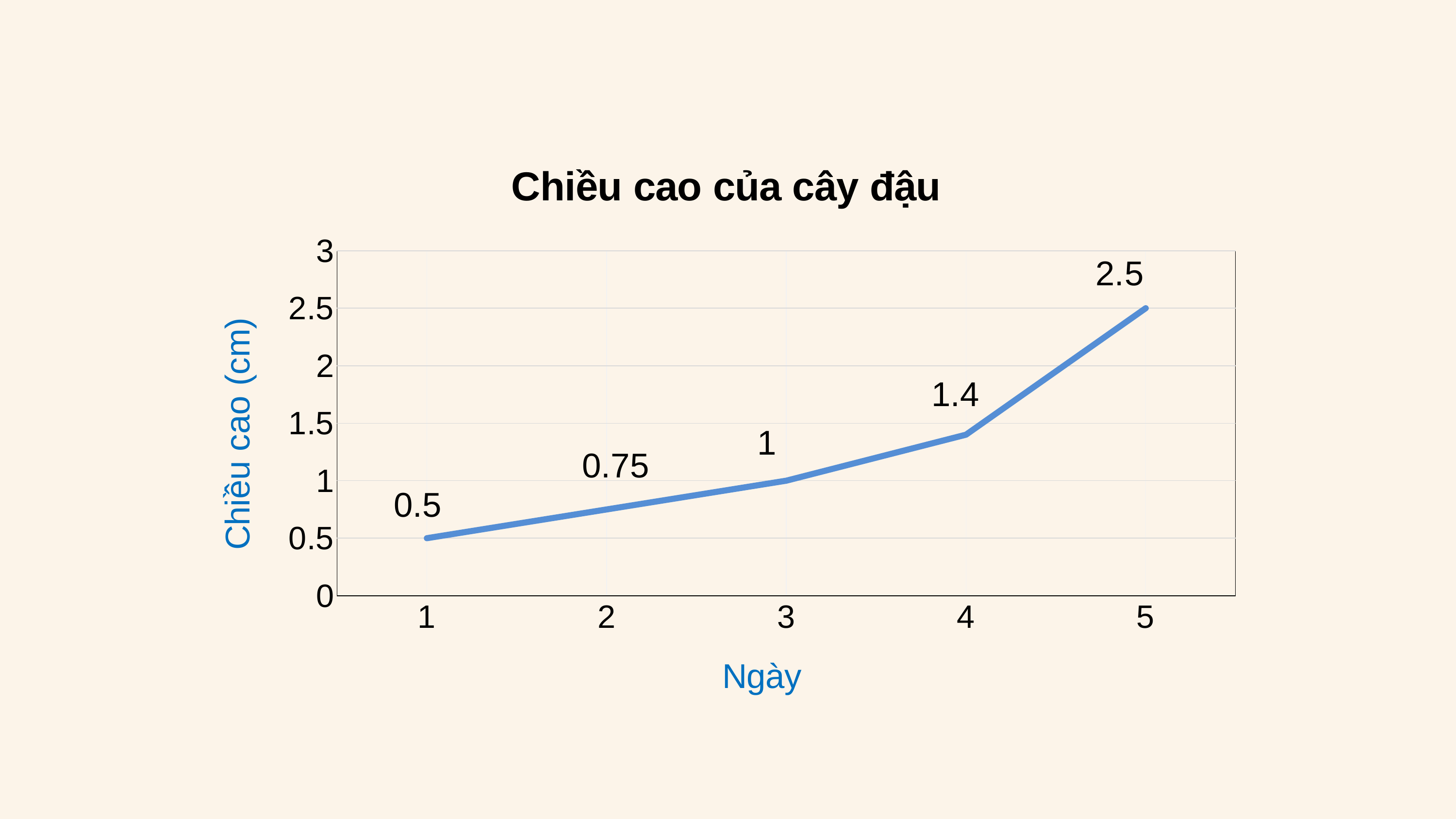
Is the value for day 4 greater or less than 1.5? less What is the difference in height between day 4 and day 1? 0.9 On which day is the plant height lowest? 1 Which day has a greater height, day 2 or day 4? 4 How many days are plotted on the chart? 5 What is the height of the bean plant on day 5? 2.5 On which day is the plant height highest? 5 Do the values rise or fall from day 1 to day 5? rise What is the difference in height between day 5 and day 4? 1.1 What is the height of the bean plant on day 2? 0.75 What kind of chart is shown on the slide? line chart What is the height of the bean plant on day 3? 1